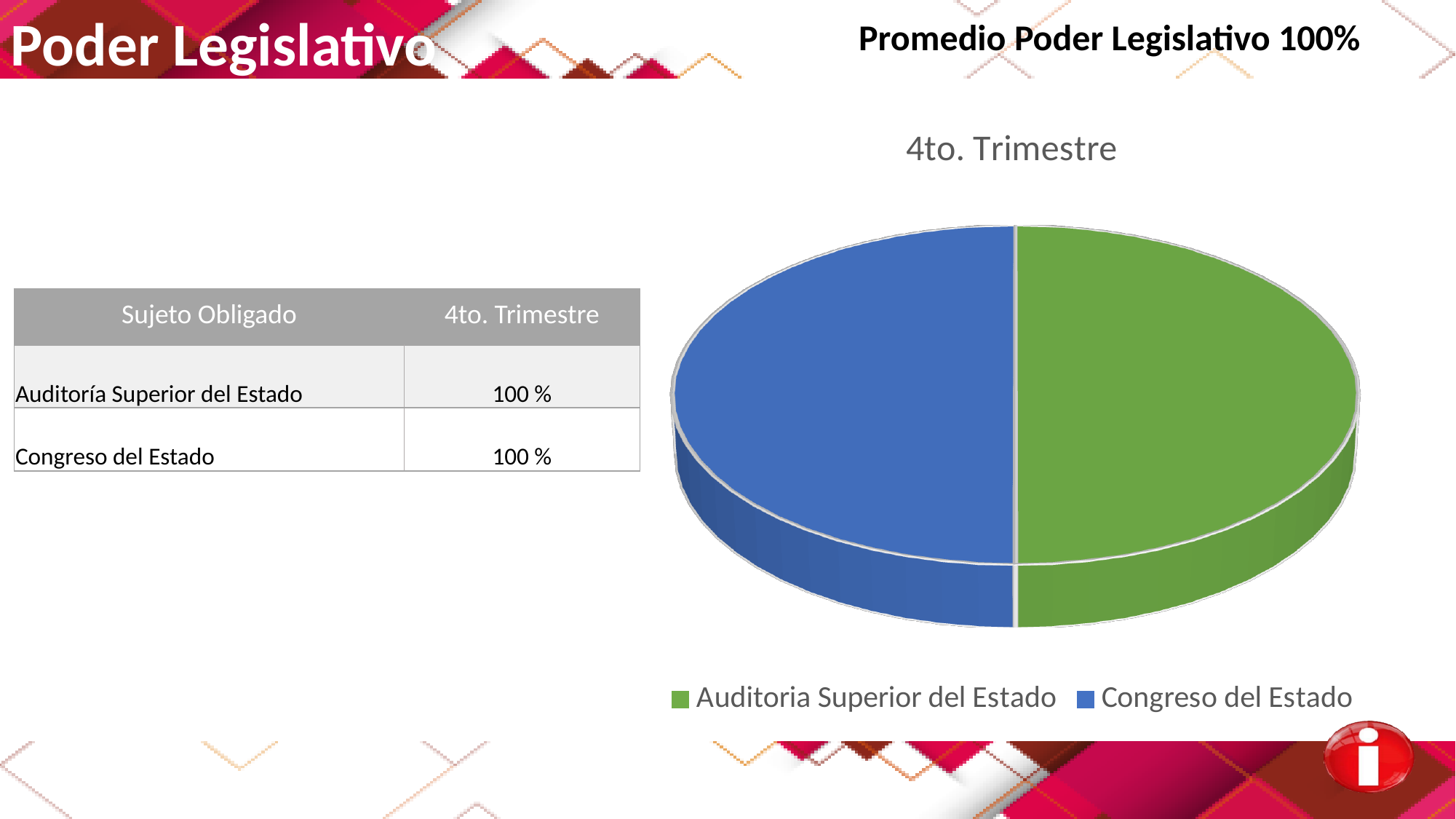
What kind of chart is shown on the slide? pie chart According to the table next to the chart, what is the 4to. Trimestre value for Congreso del Estado? 100 % What is the difference between the table values for Auditoría Superior del Estado and Congreso del Estado? 0 % According to the table next to the chart, what is the 4to. Trimestre value for Auditoría Superior del Estado? 100 % How many entries does the pie chart's legend list? 2 How many slices does the pie chart have? 2 What is the title of the pie chart? 4to. Trimestre Which category is shown in blue in the pie chart? Congreso del Estado Are the two slices of the pie chart equal in size? yes Which colour represents Auditoria Superior del Estado in the pie chart? green